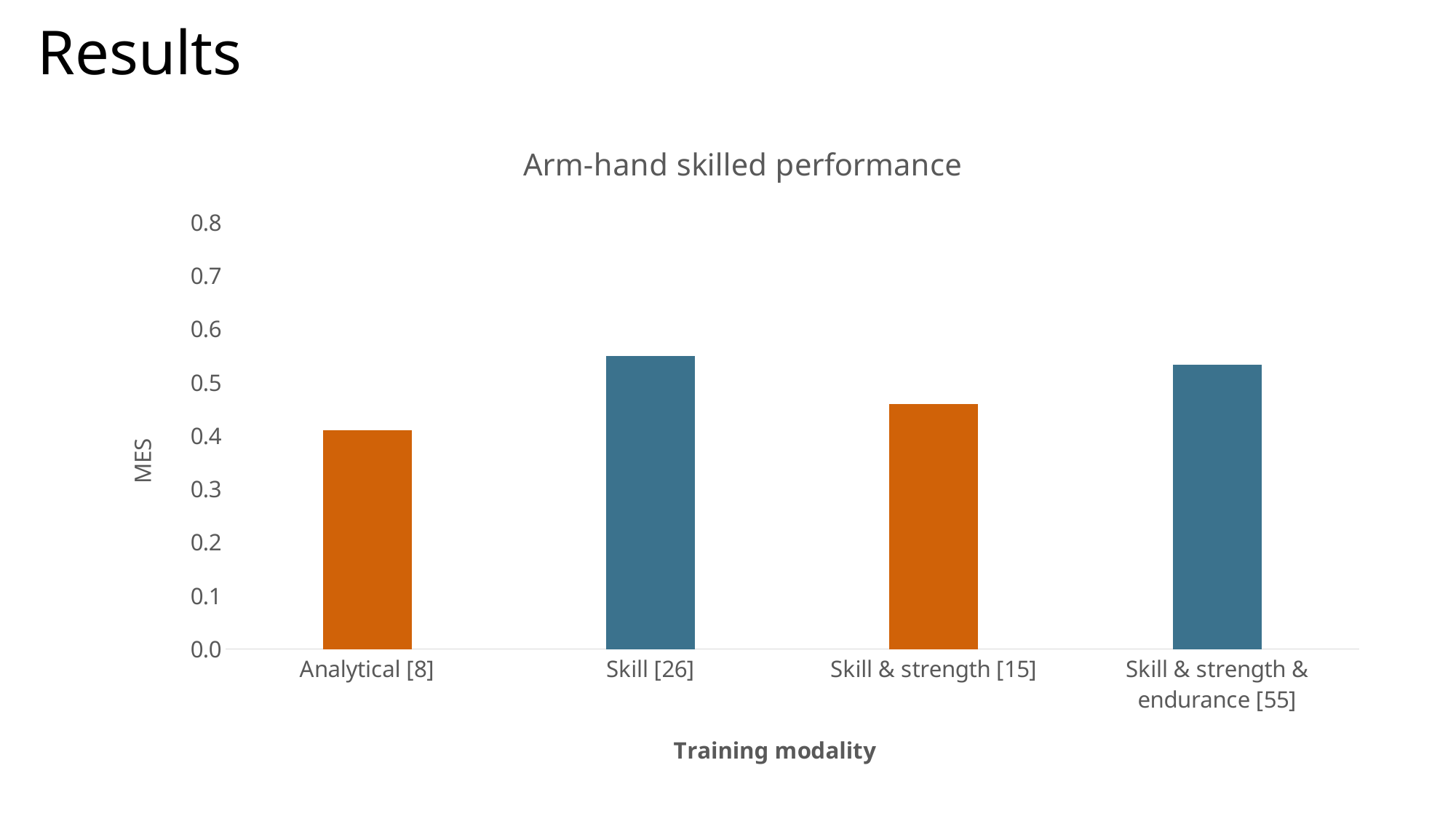
Is the MES value for Skill [26] greater or less than 0.6? less Which training modality has the lowest MES value? Analytical [8] Is the MES value for Skill & strength & endurance [55] greater or less than 0.5? greater What kind of chart is shown on the slide? bar chart Which has a higher MES value, Skill & strength [15] or Skill & strength & endurance [55]? Skill & strength & endurance [55] Is the MES value for Analytical [8] greater or less than 0.5? less How many training modalities are plotted on the chart? 4 Which has a higher MES value, Analytical [8] or Skill & strength [15]? Skill & strength [15] What is the label of the x axis? Training modality What is the title of the chart? Arm-hand skilled performance